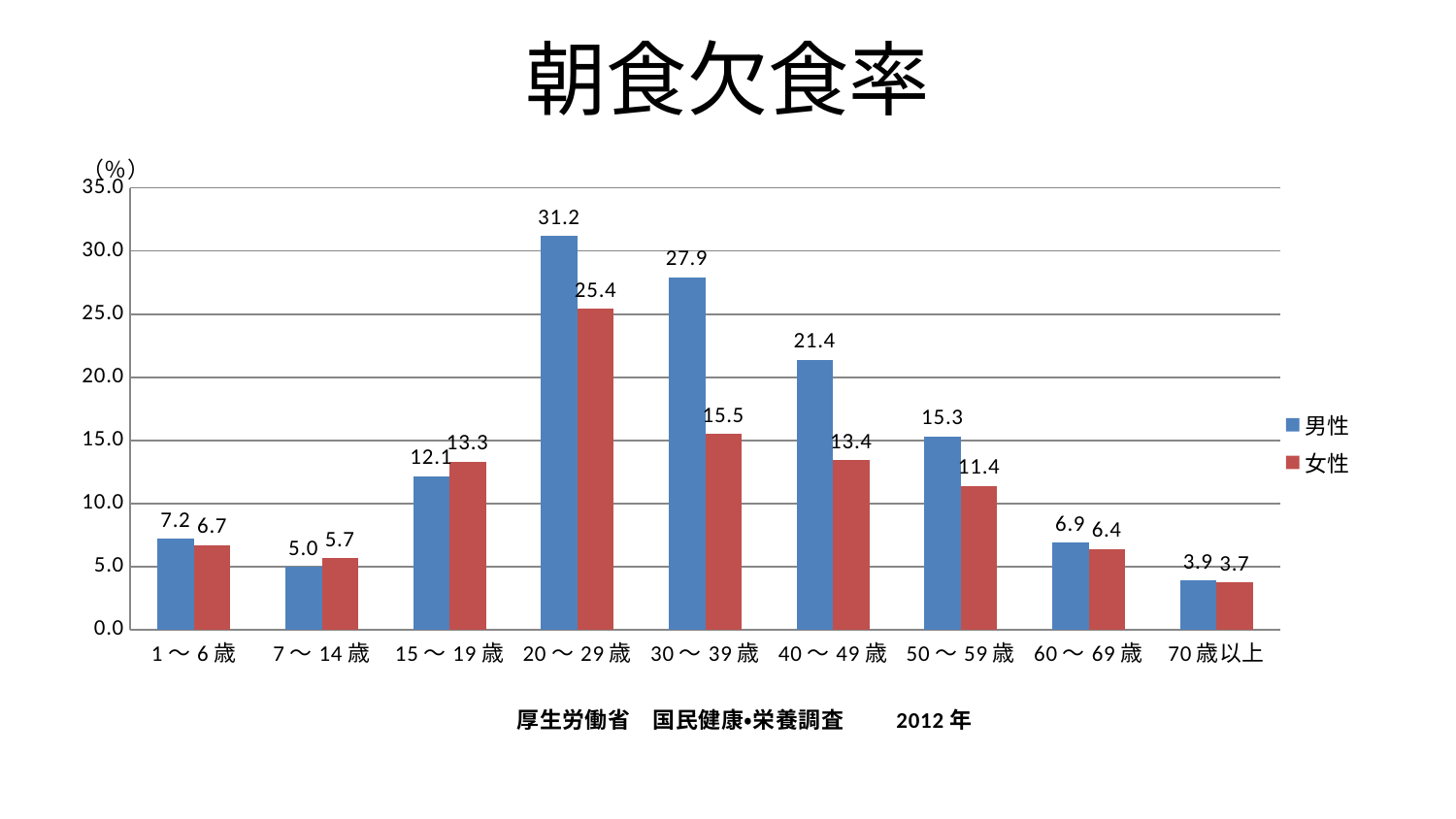
What kind of chart is shown on the slide? bar chart What is the value for 女性 in the 7～14歳 category? 5.7 What is the value for 女性 in the 40～49歳 category? 13.4 What is the title of the chart? 朝食欠食率 Which age category has the highest value for 男性? 20～29歳 How many age categories are shown on the x axis? 9 What is the difference between the 男性 and 女性 values in the 30～39歳 category? 12.4 Do the 男性 values rise or fall from 20～29歳 to 70歳以上? fall What is the value for 男性 in the 20～29歳 category? 31.2 How many series does the legend list? 2 Which age category has the lowest value for 女性? 70歳以上 Which is larger in the 15～19歳 category, the 男性 value or the 女性 value? 女性